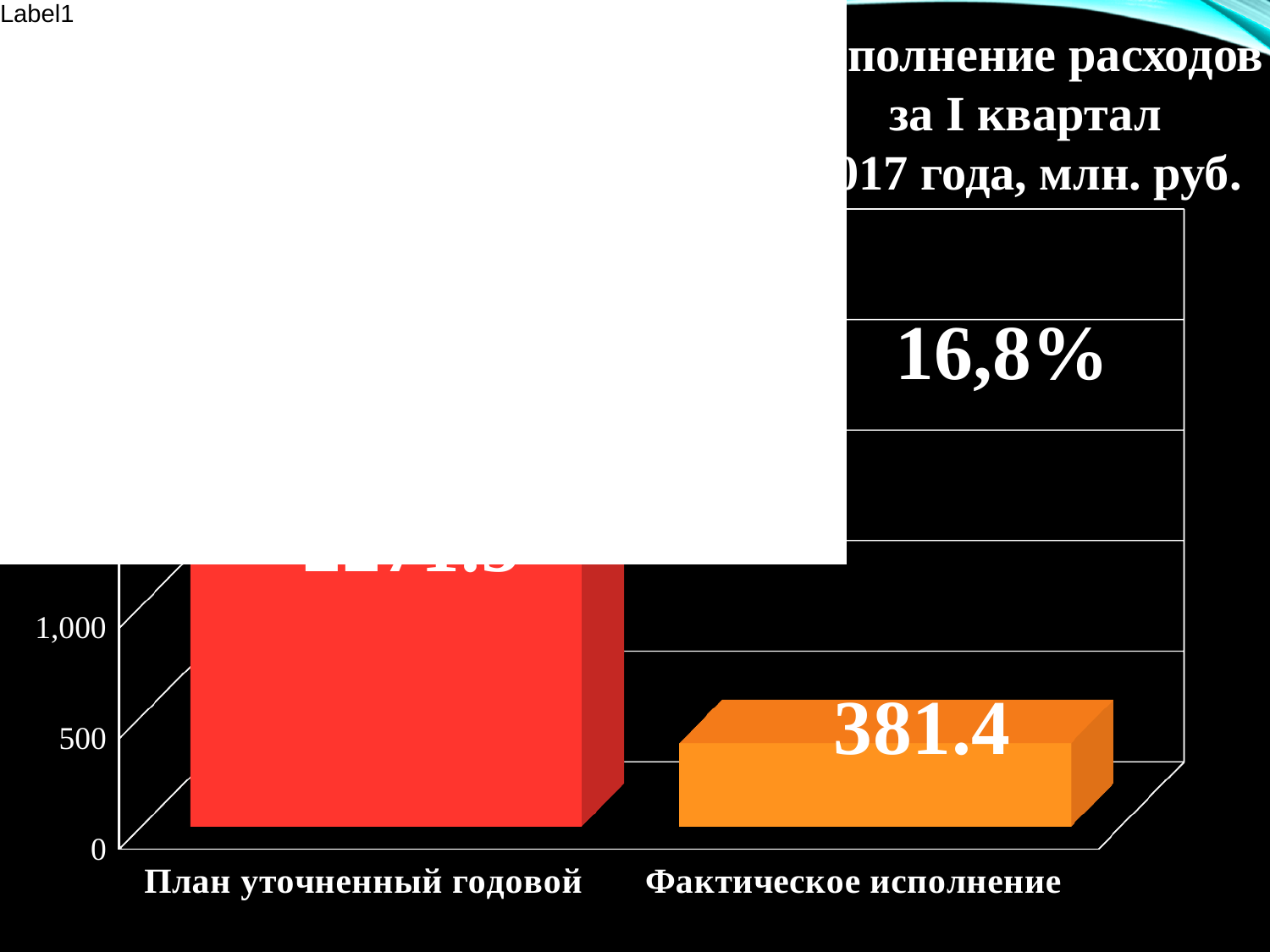
What percentage is printed in the text box to the right of the chart? 16,8% How many categories are shown on the x axis? 2 Which is larger, План уточненный годовой or Фактическое исполнение? План уточненный годовой What colour is the bar for Фактическое исполнение? orange What is the value for Фактическое исполнение? 381.4 Which category has the highest bar? План уточненный годовой Is the value for Фактическое исполнение greater or less than 500? less Which category has the lowest bar? Фактическое исполнение Do the bar values rise or fall from left to right along the x axis? fall Is the value for План уточненный годовой greater or less than 1,000? greater What kind of chart is shown on the slide? bar chart